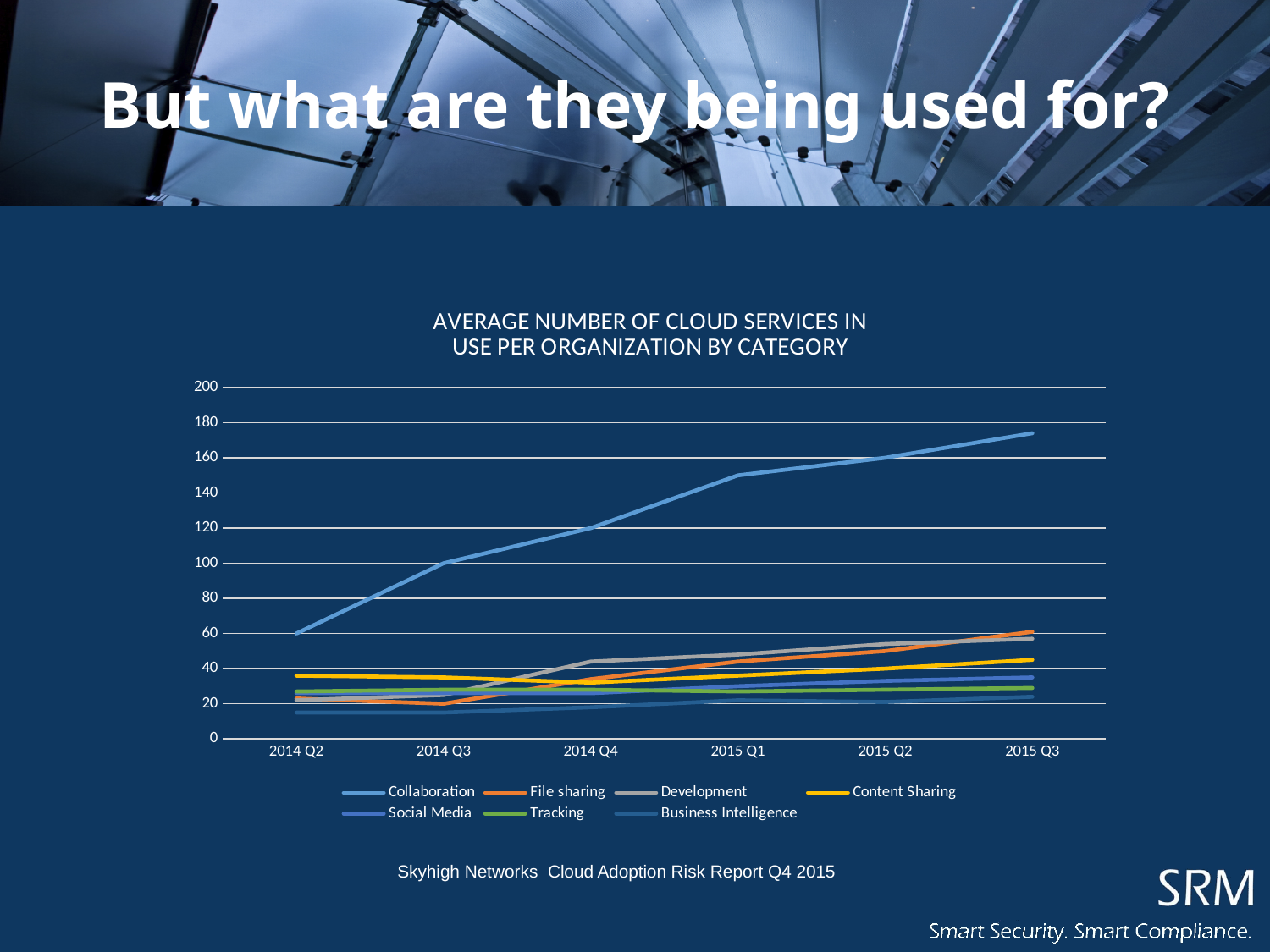
At 2014 Q2, which is larger: Content Sharing or Tracking? Content Sharing Which series has the lowest value at 2014 Q2? Business Intelligence Which series has the highest value at 2015 Q3? Collaboration At 2015 Q3, which is larger: Collaboration or File sharing? Collaboration What kind of chart is shown on the slide? line chart Is the value for Business Intelligence at 2015 Q3 greater or less than 40? less Does the Collaboration line rise or fall from 2014 Q2 to 2015 Q3? rise Is the value for Collaboration at 2015 Q3 greater or less than 160? greater How many series does the chart's legend list? 7 How many quarters are shown along the x axis of the chart? 6 Is the value for Collaboration at 2014 Q3 greater or less than 80? greater What is the title of the chart? AVERAGE NUMBER OF CLOUD SERVICES IN USE PER ORGANIZATION BY CATEGORY